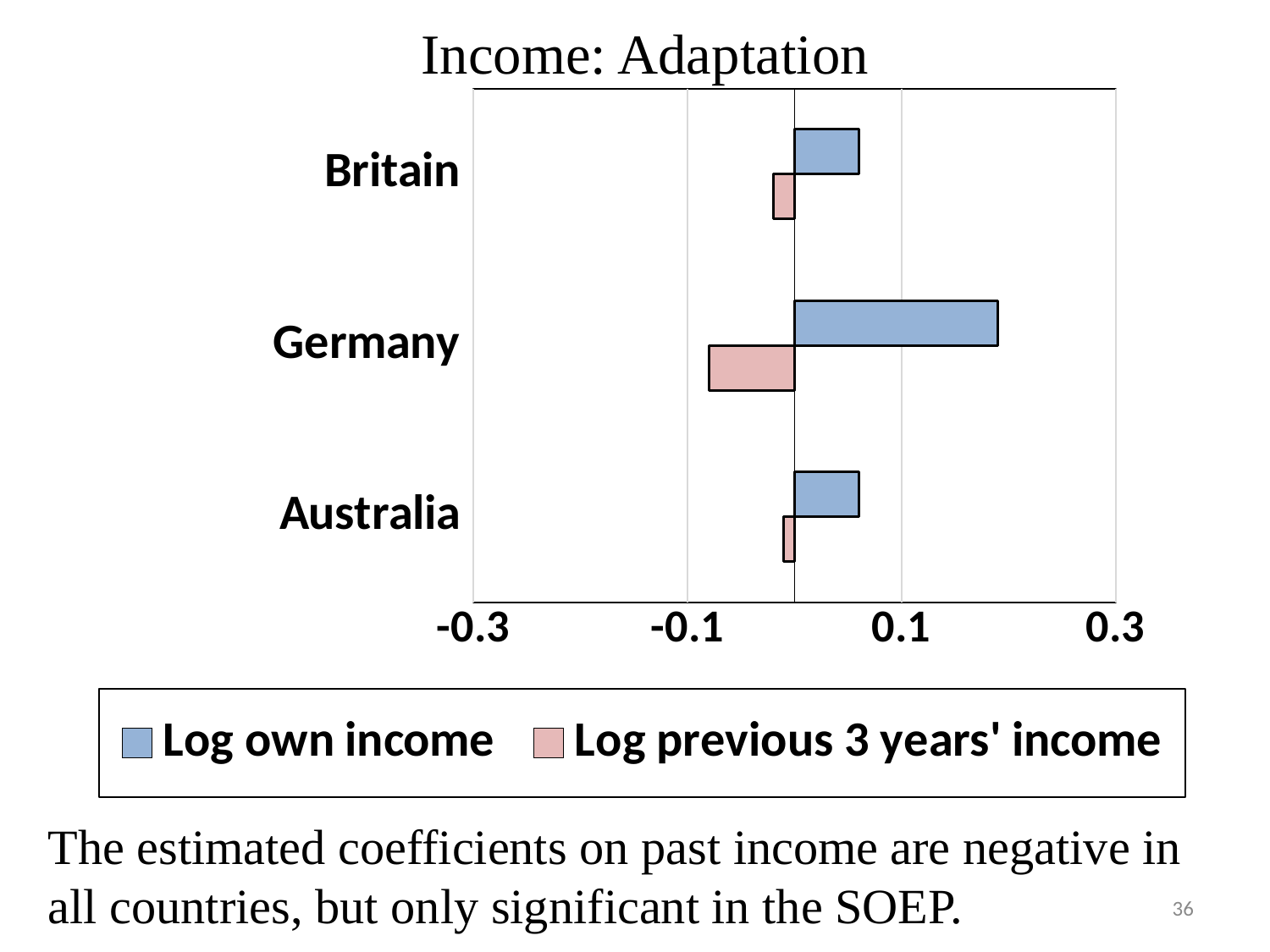
How many countries are shown on the chart? 3 Is the Log previous 3 years' income value for Germany greater or less than 0? less Is the Log own income value for Britain greater or less than 0.1? less Which series is shown in blue in the legend? Log own income Is the Log own income value for Australia greater or less than 0? greater What is the title of the chart? Income: Adaptation Which country has the lowest (most negative) value for Log previous 3 years' income? Germany What kind of chart is shown on the slide? bar chart How many series does the legend list? 2 Which is larger, the Log own income value for Germany or for Britain? Germany Which country has the highest value for Log own income? Germany